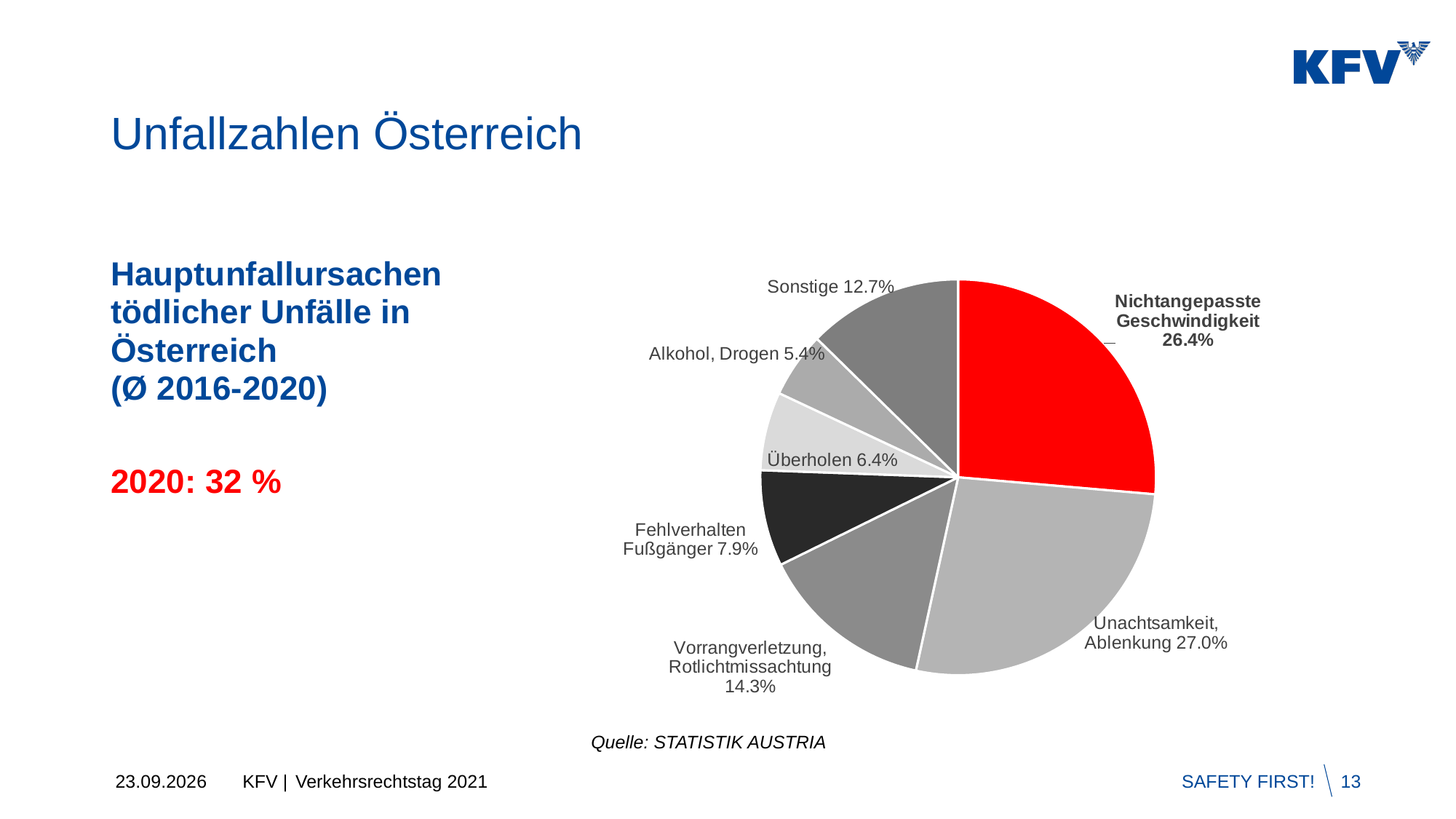
What share of fatal accidents is attributed to Nichtangepasste Geschwindigkeit? 26.4% Which category has the largest share of the pie? Unachtsamkeit, Ablenkung How many slices does the pie chart have? 7 Which is larger, the share for Vorrangverletzung, Rotlichtmissachtung or the share for Sonstige? Vorrangverletzung, Rotlichtmissachtung What percentage is shown for Vorrangverletzung, Rotlichtmissachtung? 14.3% What kind of chart is shown on the slide? Pie chart Which category has the smallest share of the pie? Alkohol, Drogen What percentage is shown for Unachtsamkeit, Ablenkung? 27.0% What percentage is shown for Fehlverhalten Fußgänger? 7.9% What percentage is shown for Alkohol, Drogen? 5.4% Which slice of the pie chart is coloured red? Nichtangepasste Geschwindigkeit What is the difference in percentage points between Sonstige and Überholen? 6.3